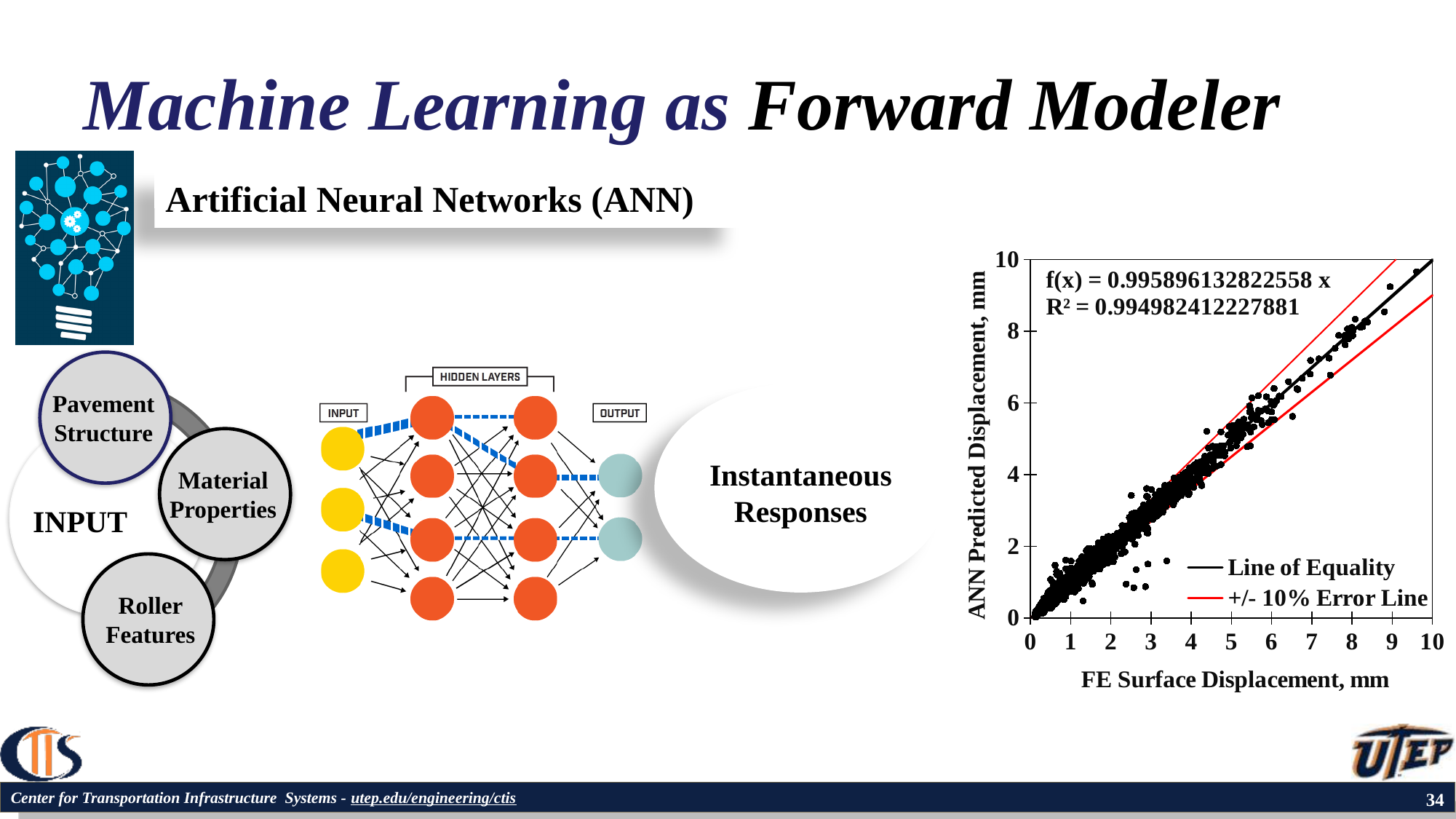
What kind of chart is shown on the right side of the slide? scatter chart What is the maximum value shown on the x axis of the scatter chart? 10 What is the title of the x axis of the scatter chart? FE Surface Displacement, mm On the scatter chart, do the plotted points rise or fall as FE Surface Displacement increases? rise What is the maximum value shown on the y axis of the scatter chart? 10 According to the legend of the scatter chart, what does the black line represent? Line of Equality What is the R² value printed on the scatter chart? 0.994982412227881 What is the slope of the fitted line f(x) printed on the scatter chart? 0.995896132822558 How many entries does the legend of the scatter chart list? 2 Is the R² value on the scatter chart greater or less than 0.9? greater What is the full fitted equation printed on the scatter chart? f(x) = 0.995896132822558 x